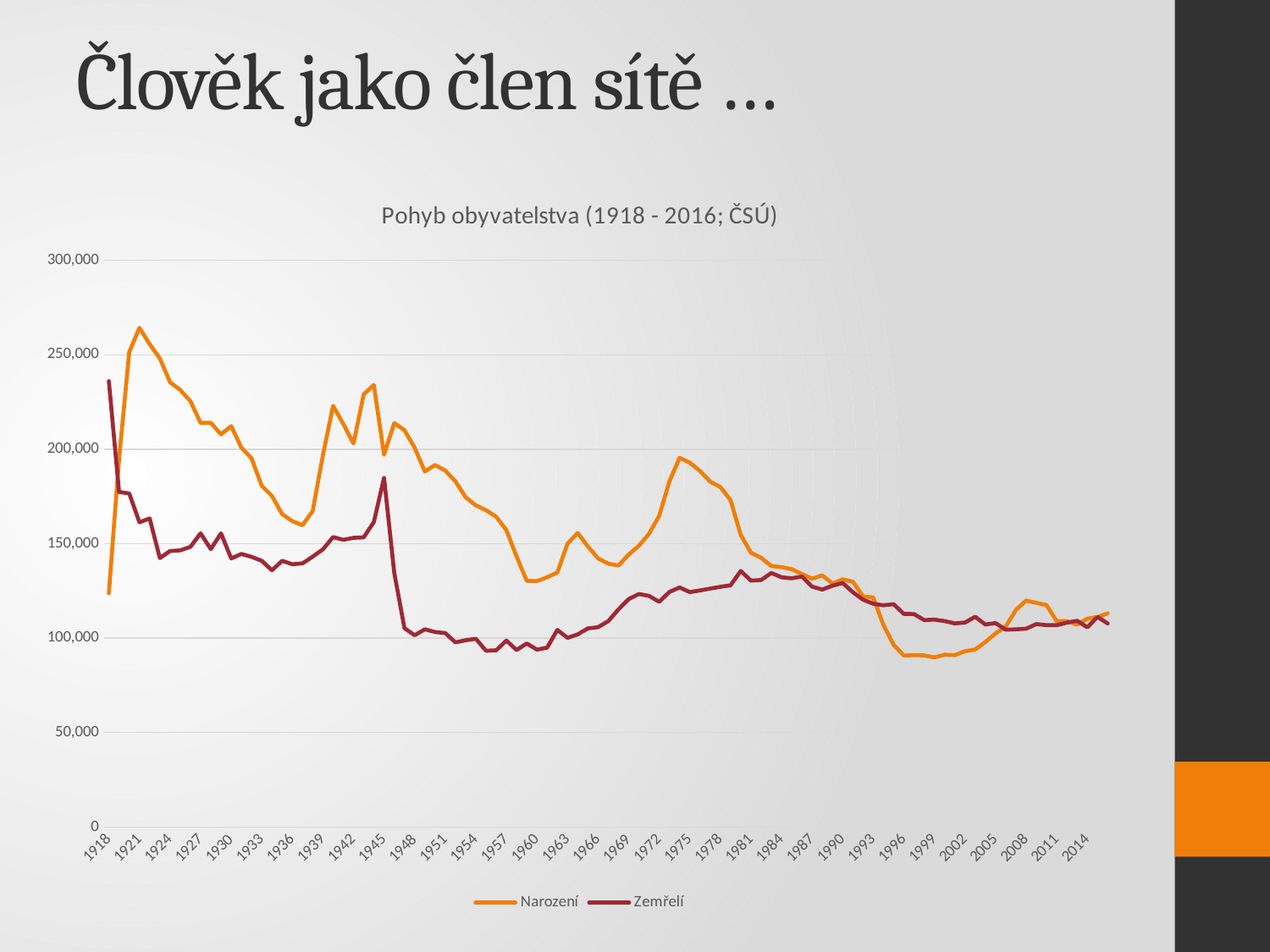
Which colour is used for the Narození series? orange Is the value for Narození in 1921 greater or less than 250,000? greater Does the Narození series rise or fall between 1975 and 1996? fall Is the value for Narození in 1996 greater or less than 100,000? less In 1918, which series has the larger value, Narození or Zemřelí? Zemřelí What is the title of the chart? Pohyb obyvatelstva (1918 - 2016; ČSÚ) In 1996, which series has the larger value, Narození or Zemřelí? Zemřelí Is the value for Zemřelí in 1918 greater or less than 200,000? greater What kind of chart is shown on the slide? line chart How many series does the legend list? 2 In 1921, which series has the larger value, Narození or Zemřelí? Narození